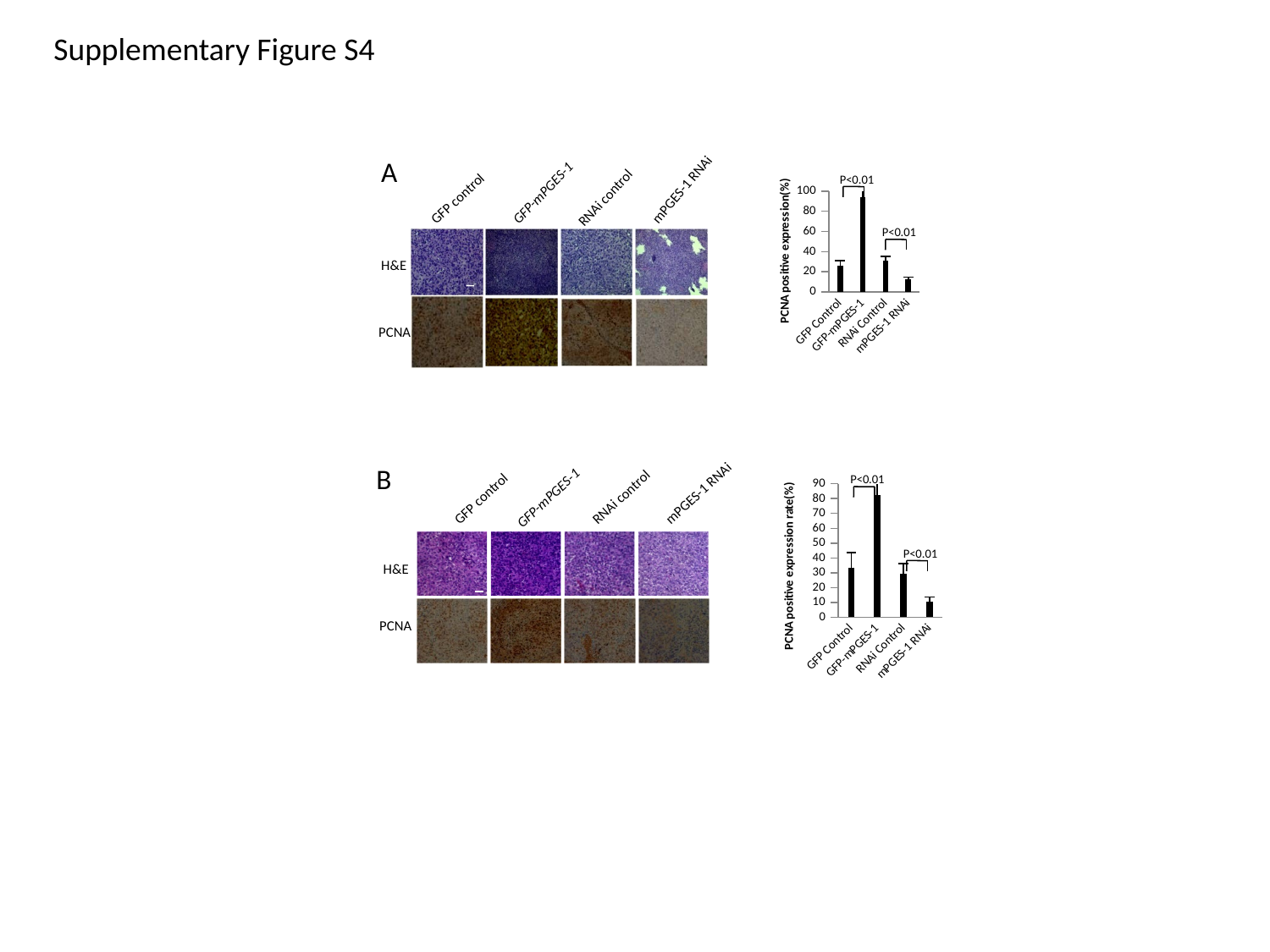
In the panel A chart (top), is the value for GFP-mPGES-1 greater or less than 80? greater In the panel B chart (bottom), which is larger, the value for GFP-mPGES-1 or the value for RNAi Control? GFP-mPGES-1 In the panel A chart (top), is the value for mPGES-1 RNAi greater or less than 20? less In the panel B chart (bottom), what P-value is annotated between GFP Control and GFP-mPGES-1? P<0.01 In the panel A chart (top), which category has the highest PCNA positive expression? GFP-mPGES-1 In the panel A chart (top), what is the y-axis label? PCNA positive expression(%) In the panel B chart (bottom), which category has the lowest PCNA positive expression rate? mPGES-1 RNAi In the panel A chart (top), which category has the lowest PCNA positive expression? mPGES-1 RNAi In the panel A chart (top), how many categories are plotted on the x axis? 4 In the panel A chart (top), what kind of chart is shown? bar chart In the panel B chart (bottom), is the value for GFP-mPGES-1 greater or less than 70? greater In the panel B chart (bottom), which category has the highest PCNA positive expression rate? GFP-mPGES-1